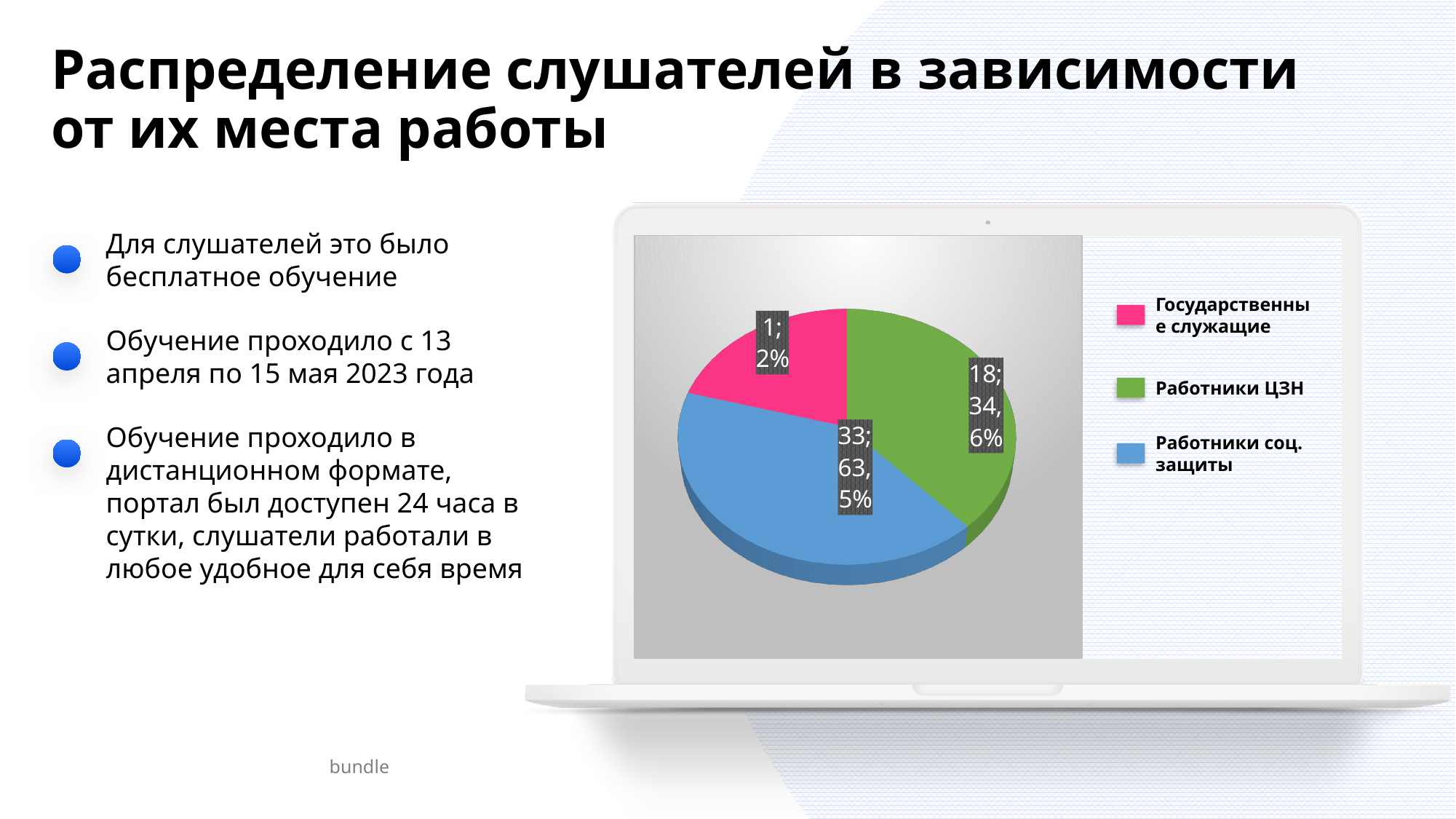
What kind of chart is shown on the slide? pie chart What is the count shown for Работники ЦЗН in the pie chart? 18 What is the count shown for Государственные служащие in the pie chart? 1 Which category has the smallest slice in the pie chart? Государственные служащие What share of the pie does Работники ЦЗН take? 34,6% Which category has the largest slice in the pie chart? Работники соц. защиты How many entries does the legend of the pie chart list? 3 What share of the pie does Работники соц. защиты take? 63,5% How many slices does the pie chart have? 3 What is the difference between the counts for Работники соц. защиты and Работники ЦЗН? 15 What is the count shown for Работники соц. защиты in the pie chart? 33 What share of the pie does Государственные служащие take? 2%